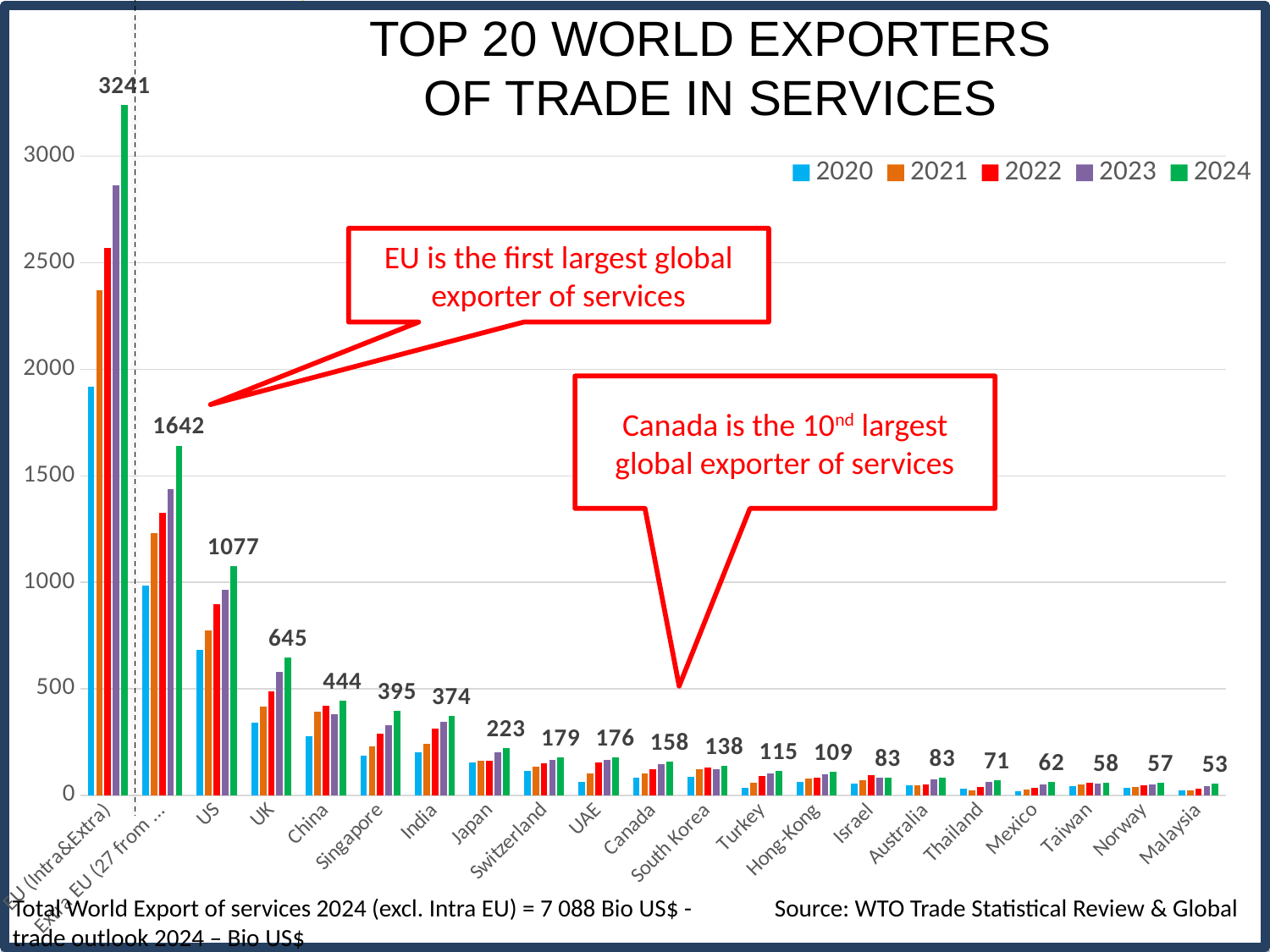
What is the 2024 value for the US? 1077 What is the 2024 value for Canada? 158 Which exporter has the lowest 2024 value? Malaysia How many series does the legend list? 5 How many exporters are shown on the x axis? 21 Which has the larger 2024 value, Japan or Switzerland? Japan What is the title of the chart? TOP 20 WORLD EXPORTERS OF TRADE IN SERVICES What kind of chart is shown on the slide? bar chart Is the 2020 value for the US greater or less than 500? greater What is the difference between the 2024 values for the US and the UK? 432 Do the values for EU (Intra&Extra) rise or fall from 2020 to 2024? rise Which exporter has the highest 2024 value? EU (Intra&Extra)